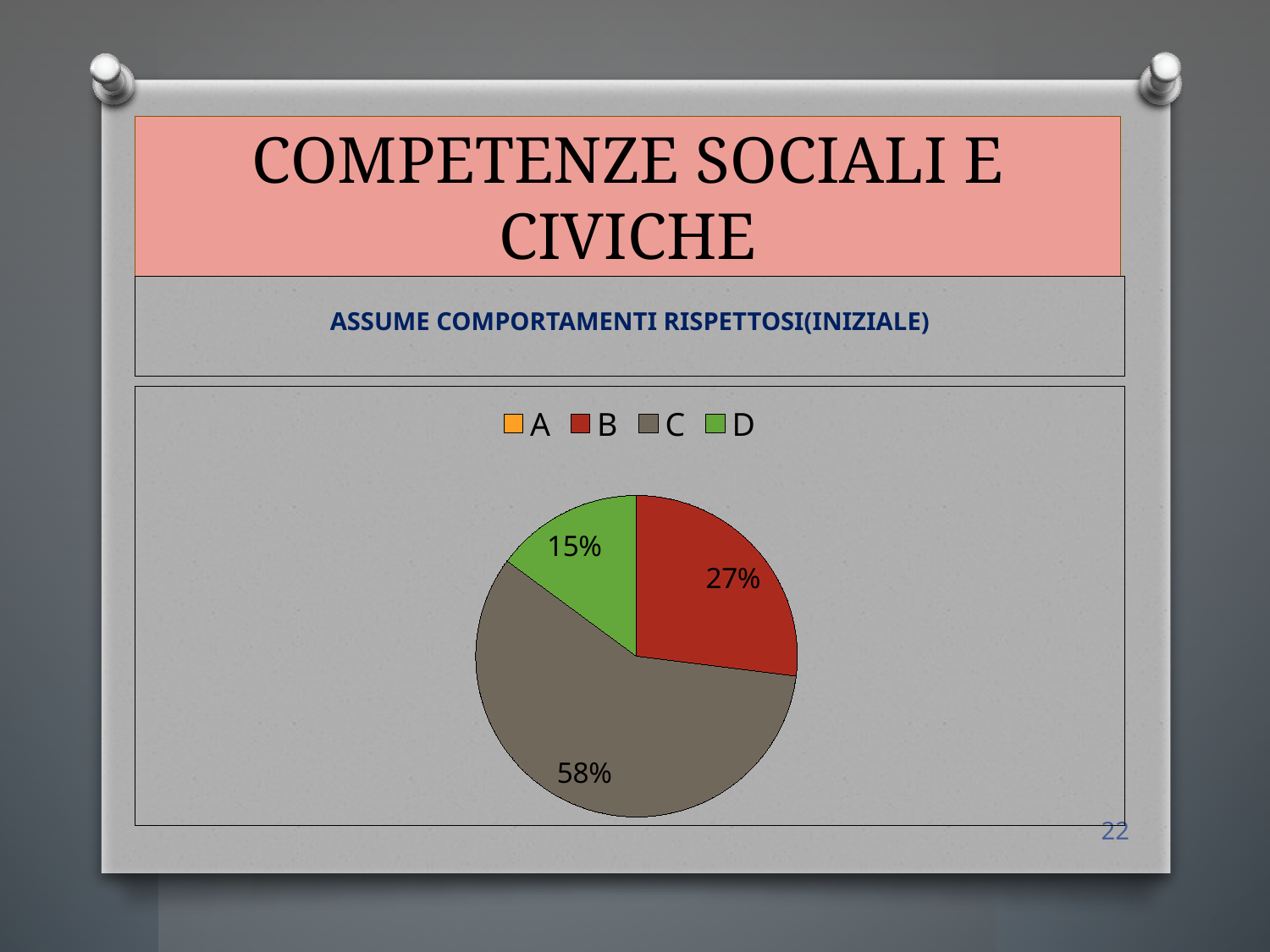
Which slice is larger, B or D? B What is the title shown above the pie chart? ASSUME COMPORTAMENTI RISPETTOSI(INIZIALE) What kind of chart is shown on the slide? Pie chart What is the difference in percentage points between slice C and slice B? 31% What percentage does slice D represent in the pie chart? 15% Among the slices with a printed percentage, which category has the smallest slice? D Which category has the largest slice in the pie chart? C What percentage does slice C represent in the pie chart? 58% What is the difference in percentage points between slice B and slice D? 12% How many entries does the legend of the pie chart list? 4 What percentage does slice B represent in the pie chart? 27% How many slices with a printed percentage label are visible in the pie chart? 3